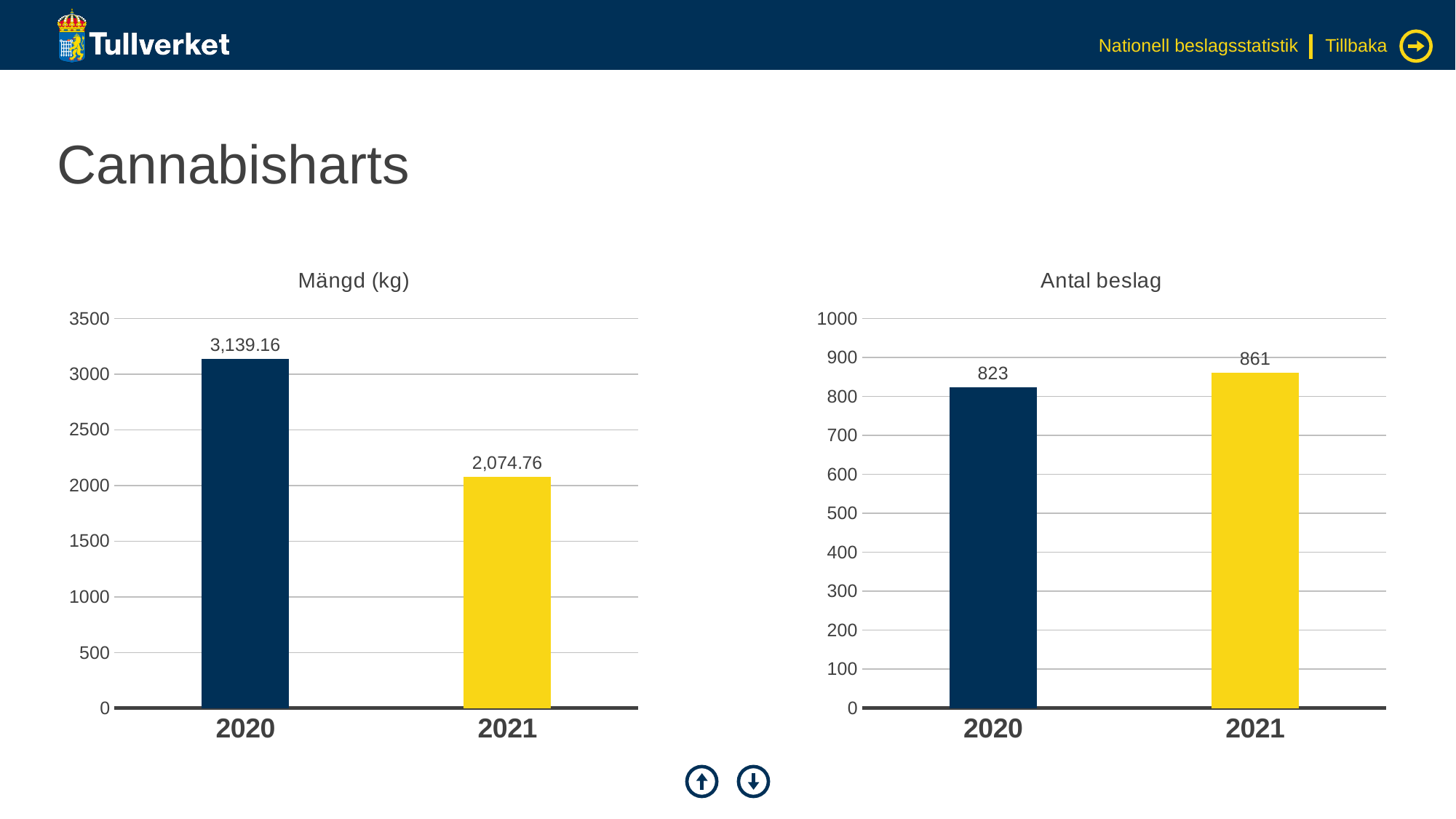
In the 'Antal beslag' chart, is the value for 2021 greater or less than 800? greater In the 'Antal beslag' chart, what is the difference between the 2021 and 2020 values? 38 What kind of chart is the 'Mängd (kg)' chart? bar chart In the 'Mängd (kg)' chart, which year has the highest value? 2020 In the 'Mängd (kg)' chart, what is the value for 2021? 2,074.76 In the 'Mängd (kg)' chart, what is the difference between the 2020 and 2021 values? 1,064.40 In the 'Antal beslag' chart, what is the value for 2020? 823 In the 'Mängd (kg)' chart, what is the value for 2020? 3,139.16 In the 'Antal beslag' chart, what is the value for 2021? 861 In the 'Mängd (kg)' chart, do the values rise or fall from 2020 to 2021? fall In the 'Antal beslag' chart, which year has the lowest value? 2020 How many categories are shown in the 'Antal beslag' chart? 2